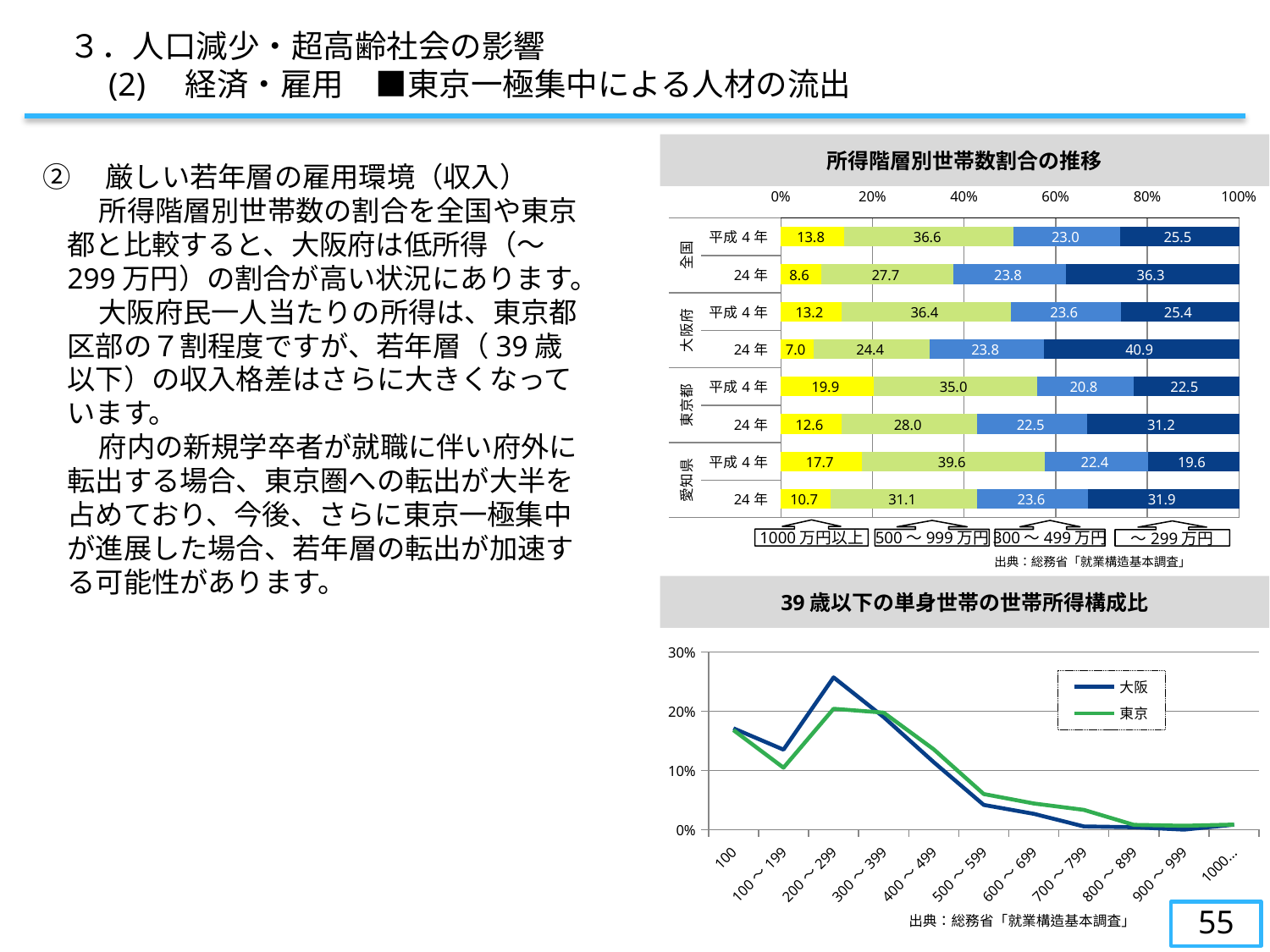
In the chart titled 所得階層別世帯数割合の推移, how many series does the legend list? 4 In the chart titled 所得階層別世帯数割合の推移, what is the difference between the ～299万円 values for 大阪府 in 平成4年 and 24年? 15.5 In the chart titled 所得階層別世帯数割合の推移, what is the value of the 500～999万円 segment for 愛知県 in 24年? 31.1 In the chart titled 所得階層別世帯数割合の推移, which is larger: the 1000万円以上 value for 全国 in 24年 or for 東京都 in 24年? 東京都 24年 In the chart titled 所得階層別世帯数割合の推移, which bar has the highest ～299万円 value? 大阪府 24年 In the chart titled 所得階層別世帯数割合の推移, what is the value of the ～299万円 segment for 大阪府 in 24年? 40.9 What kind of chart is the chart titled 39歳以下の単身世帯の世帯所得構成比? line chart In the chart titled 39歳以下の単身世帯の世帯所得構成比, how many series does the legend list? 2 In the chart titled 39歳以下の単身世帯の世帯所得構成比, is the value for 大阪 at 200～299 greater or less than 20%? greater In the chart titled 所得階層別世帯数割合の推移, which bar has the lowest 1000万円以上 value? 大阪府 24年 In the chart titled 所得階層別世帯数割合の推移, what is the value of the 1000万円以上 segment for 東京都 in 平成4年? 19.9 In the chart titled 39歳以下の単身世帯の世帯所得構成比, is the value for 大阪 at 500～599 greater or less than 10%? less